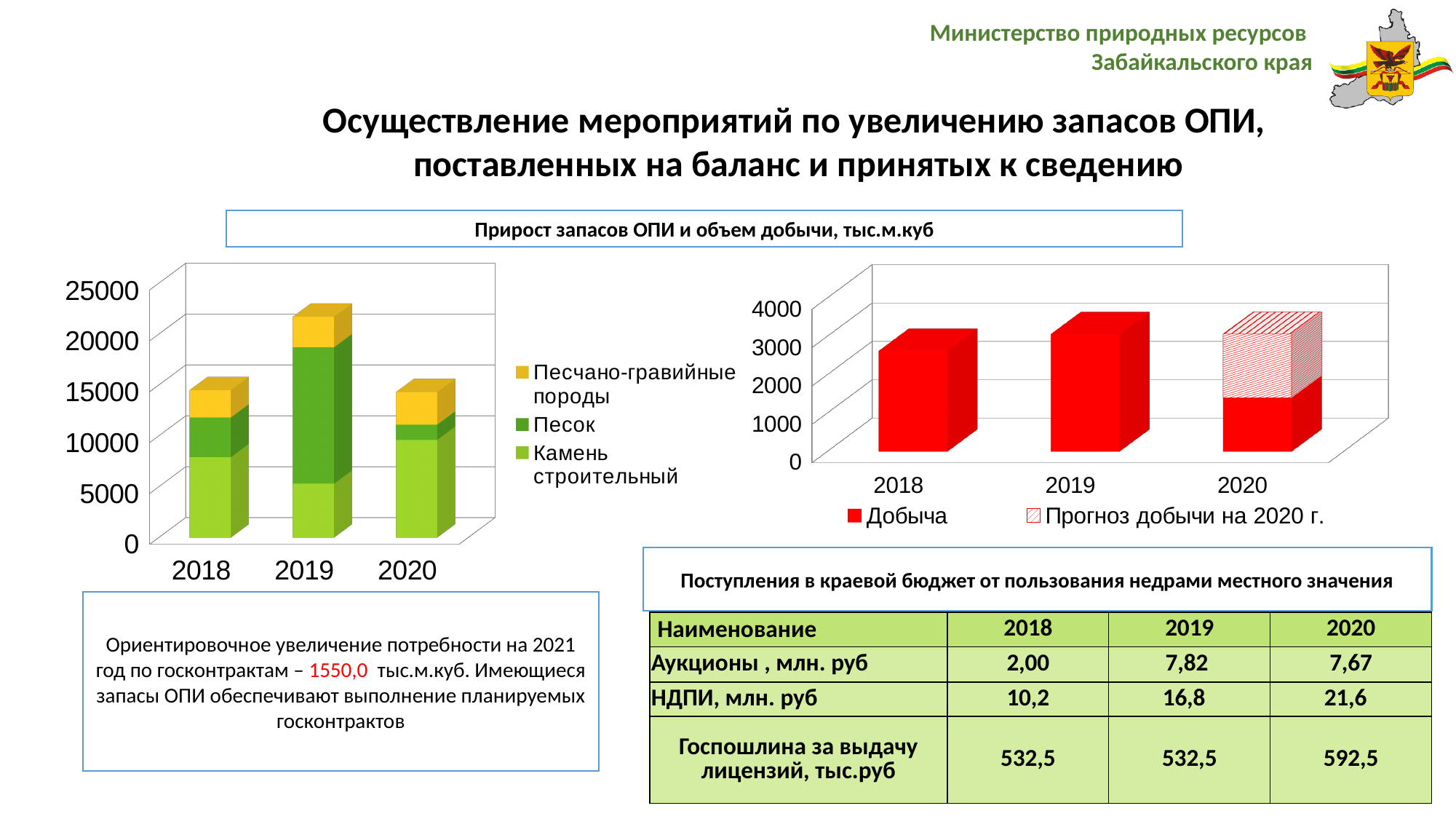
How many series does the legend of the left chart (Прирост запасов ОПИ) list? 3 How many years are shown on the x axis of the left chart (Прирост запасов ОПИ)? 3 In the right chart (объем добычи), which year has the lowest Добыча value? 2020 In the left chart (Прирост запасов ОПИ), is the value for Камень строительный in 2020 greater or less than 5000? greater In the left chart (Прирост запасов ОПИ), which year has the lowest value for Камень строительный? 2019 What type of chart is the left chart showing Прирост запасов ОПИ? stacked bar chart In the right chart (объем добычи), is the Добыча value for 2018 greater or less than 2000? greater In the right chart (объем добычи), which series is shown with a hatched pattern? Прогноз добычи на 2020 г. In the left chart (Прирост запасов ОПИ), is the total for 2019 greater or less than 15000? greater In the left chart (Прирост запасов ОПИ), which year has the highest total stacked bar? 2019 In the left chart (Прирост запасов ОПИ), which year has the larger Песок segment, 2018 or 2019? 2019 How many series does the legend of the right chart (объем добычи) list? 2